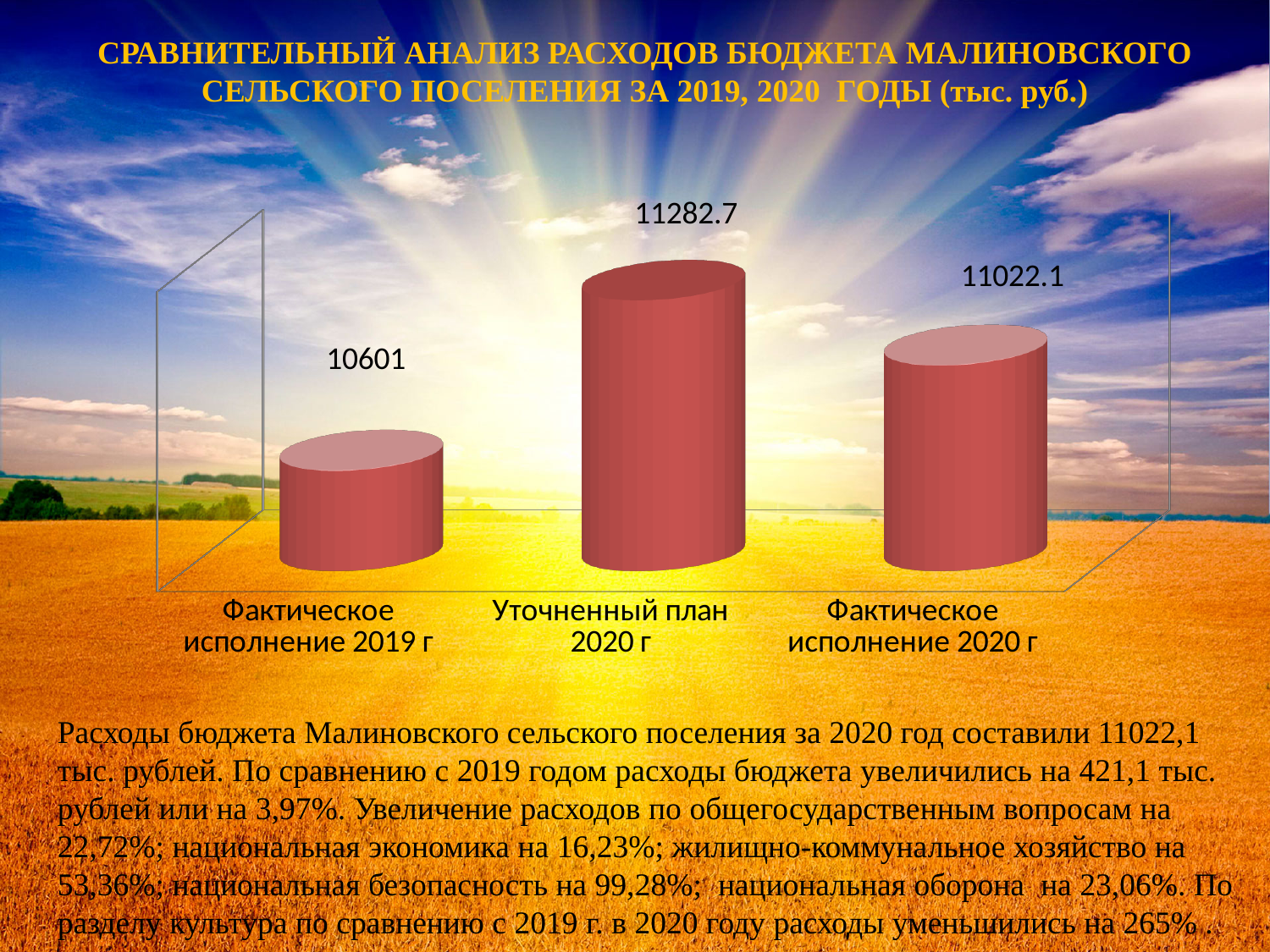
What is the value for Уточненный план 2020 г? 11282.7 What is the difference between Уточненный план 2020 г and Фактическое исполнение 2020 г? 260.6 What is the value for Фактическое исполнение 2019 г? 10601 What kind of chart is shown on the slide? bar chart What unit is stated in the chart title? тыс. руб. Which category has the lowest value? Фактическое исполнение 2019 г Which is larger: Фактическое исполнение 2019 г or Фактическое исполнение 2020 г? Фактическое исполнение 2020 г Which category has the highest value? Уточненный план 2020 г What is the value for Фактическое исполнение 2020 г? 11022.1 What is the difference between Фактическое исполнение 2020 г and Фактическое исполнение 2019 г? 421.1 How many categories are shown in the chart? 3 Does the value rise or fall from Фактическое исполнение 2019 г to Уточненный план 2020 г? rise